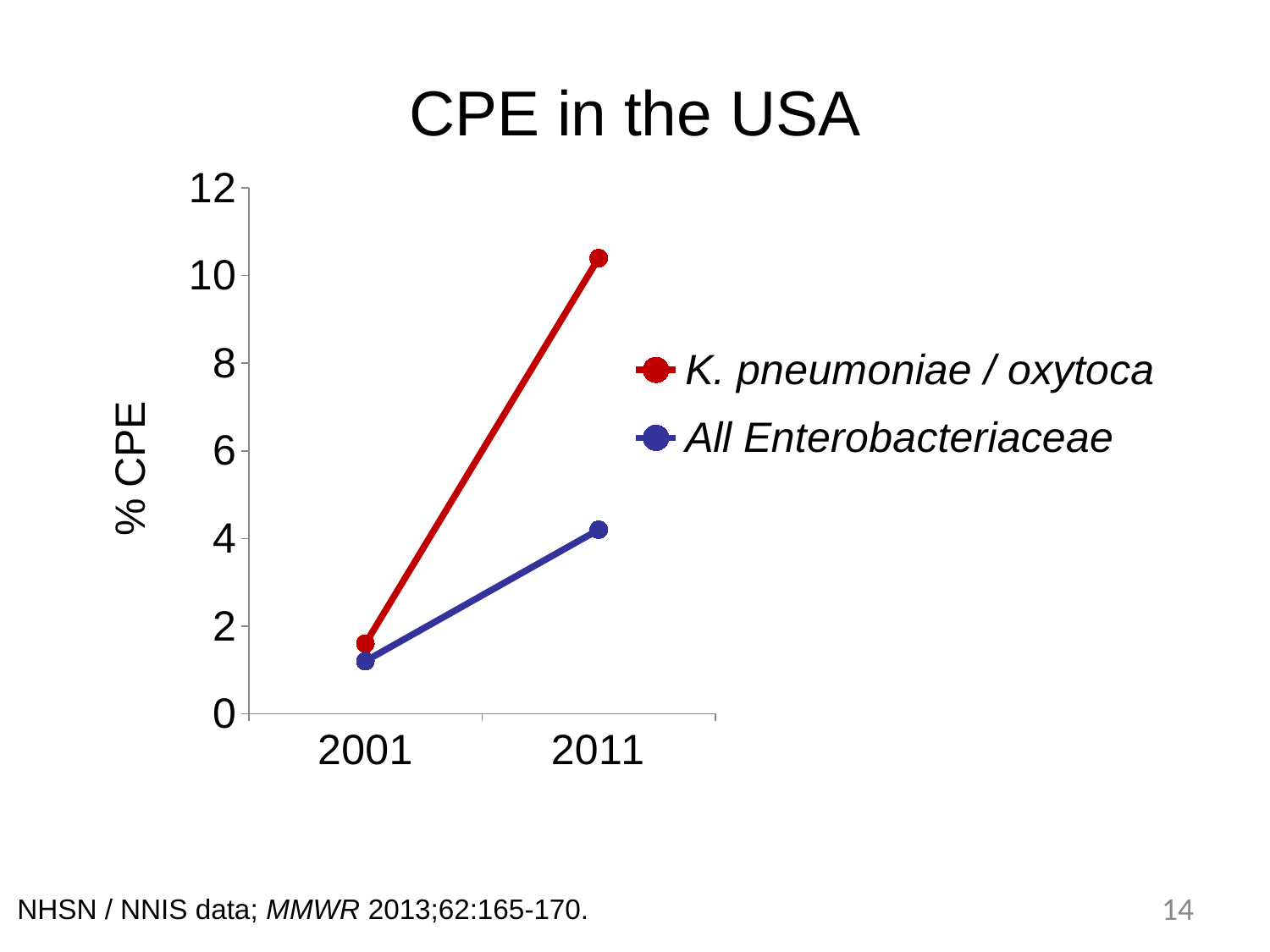
Does the % CPE for K. pneumoniae / oxytoca rise or fall from 2001 to 2011? rise Is the % CPE for K. pneumoniae / oxytoca in 2001 greater or less than 2? less How many series does the legend list? 2 Is the % CPE for All Enterobacteriaceae in 2011 greater or less than 2? greater How many years are plotted on the x axis? 2 What is the title of the chart? CPE in the USA In 2011, which series has the higher % CPE, K. pneumoniae / oxytoca or All Enterobacteriaceae? K. pneumoniae / oxytoca Is the % CPE for All Enterobacteriaceae in 2011 greater or less than 6? less What is the label of the y axis? % CPE Does the % CPE for All Enterobacteriaceae rise or fall from 2001 to 2011? rise What kind of chart is shown on the slide? line chart